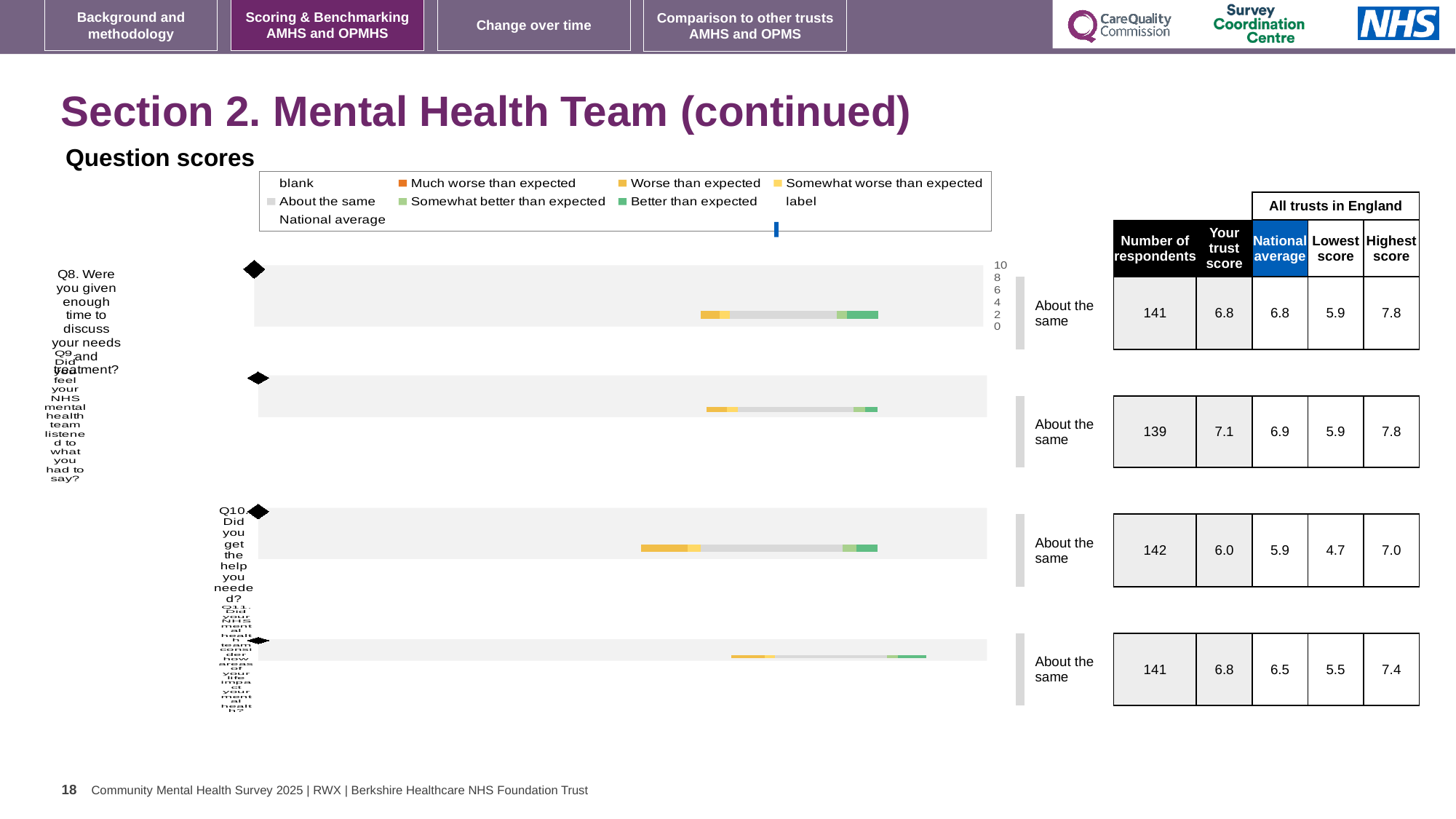
For the Q9 chart, what is 'Your trust score' shown in the table? 7.1 How many question charts (Q8 to Q11) are shown on the slide? 4 What colour represents 'Much worse than expected' in the legend? orange For the Q10 chart, which is larger: your trust score or the national average? Your trust score How many entries does the legend above the question score charts list? 9 For the Q11 chart, what is the highest score among all trusts in England? 7.4 What colour represents 'Better than expected' in the legend? green For the Q8 chart, what is the number of respondents shown in the table? 141 What benchmark category label is shown next to the Q9 chart? About the same For the Q10 chart, what is the national average shown in the table? 5.9 What kind of chart is used to show the question scores for Q8 to Q11? bar chart For the Q10 chart, what is the difference between the highest score and the lowest score? 2.3